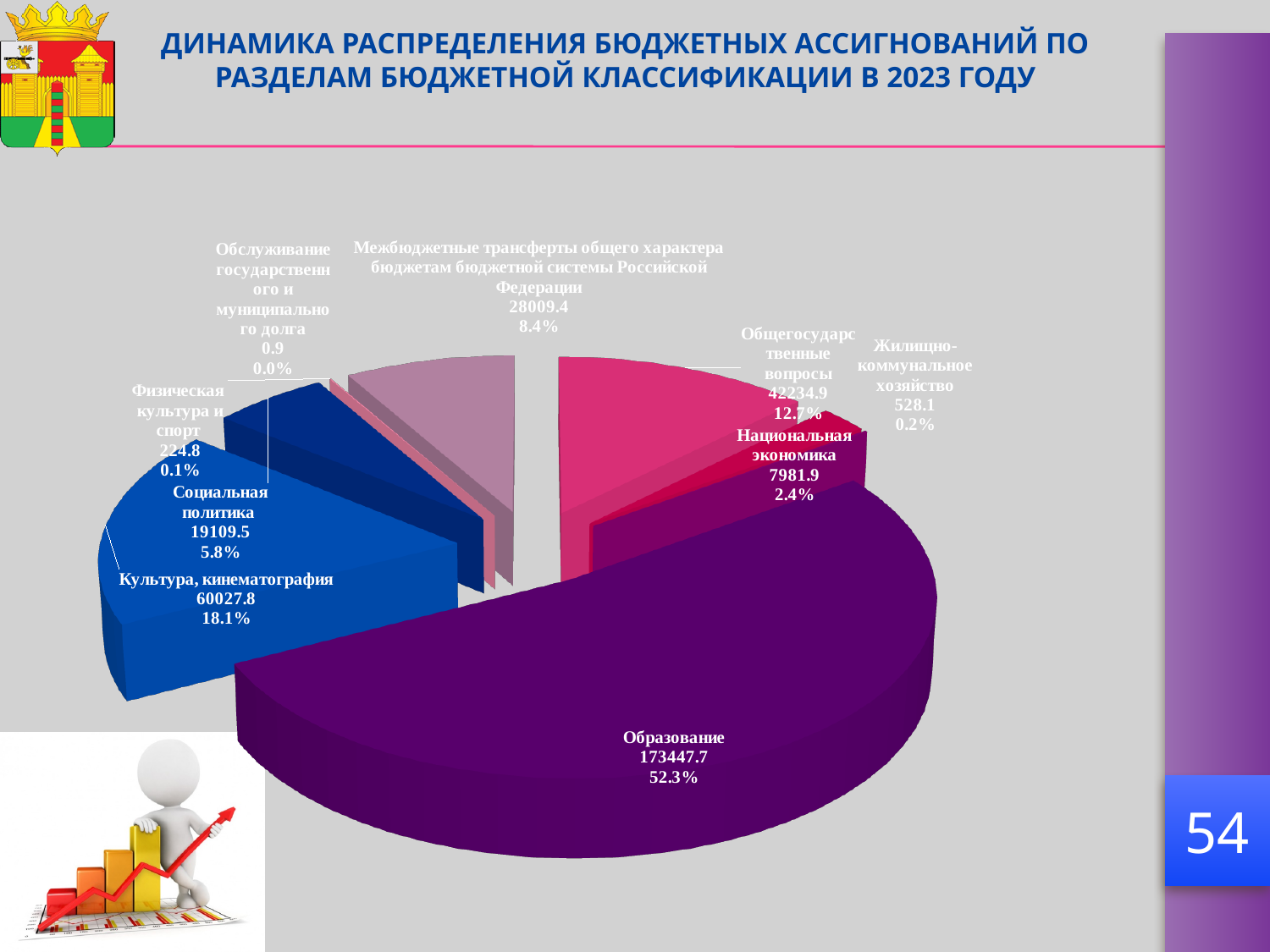
What is the value shown for Культура, кинематография? 60027.8 What is the value shown for Общегосударственные вопросы? 42234.9 Which category has the largest slice of the pie? Образование Which is larger, Национальная экономика or Социальная политика? Социальная политика What share of the pie does Межбюджетные трансферты общего характера бюджетам бюджетной системы Российской Федерации represent? 8.4% How many categories are shown in the pie chart? 9 What is the value shown for Образование? 173447.7 What is the difference between the values for Общегосударственные вопросы and Национальная экономика? 34253.0 What type of chart is shown on the slide? Pie chart What share of the pie does Образование represent? 52.3% What is the value shown for Социальная политика? 19109.5 Which category has the smallest value? Обслуживание государственного и муниципального долга